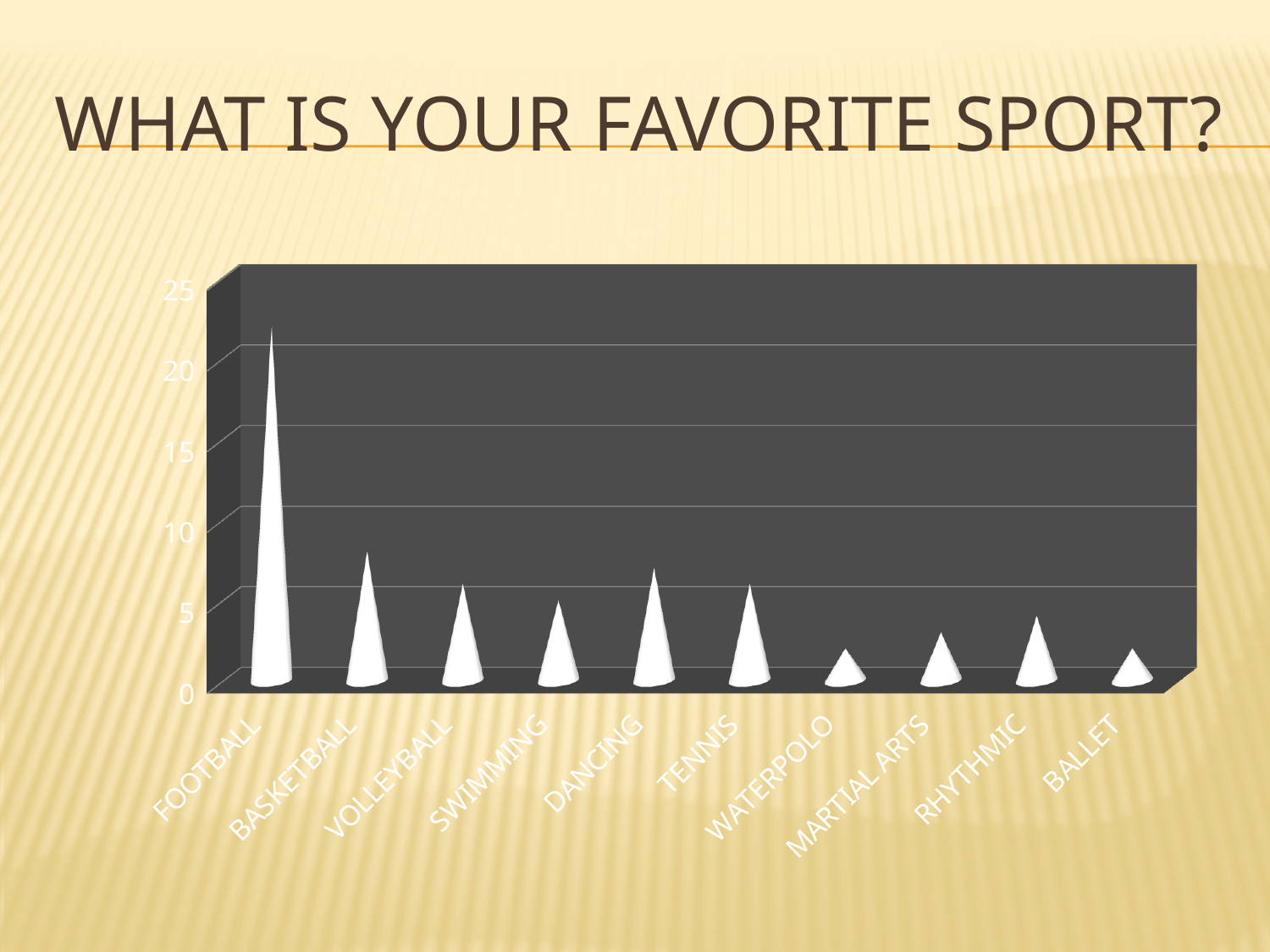
Is the value for Football greater or less than 10? greater Which has a larger value, Football or Basketball? Football Which sport has the highest value in the chart? Football Which has a larger value, Dancing or Waterpolo? Dancing How many sports are shown on the x axis of the chart? 10 Is the value for Football greater or less than 15? greater Is the value for Waterpolo greater or less than 5? less Which has a larger value, Basketball or Ballet? Basketball What kind of chart is shown on the slide? bar chart What is the title of the slide containing the chart? What is your favorite sport?